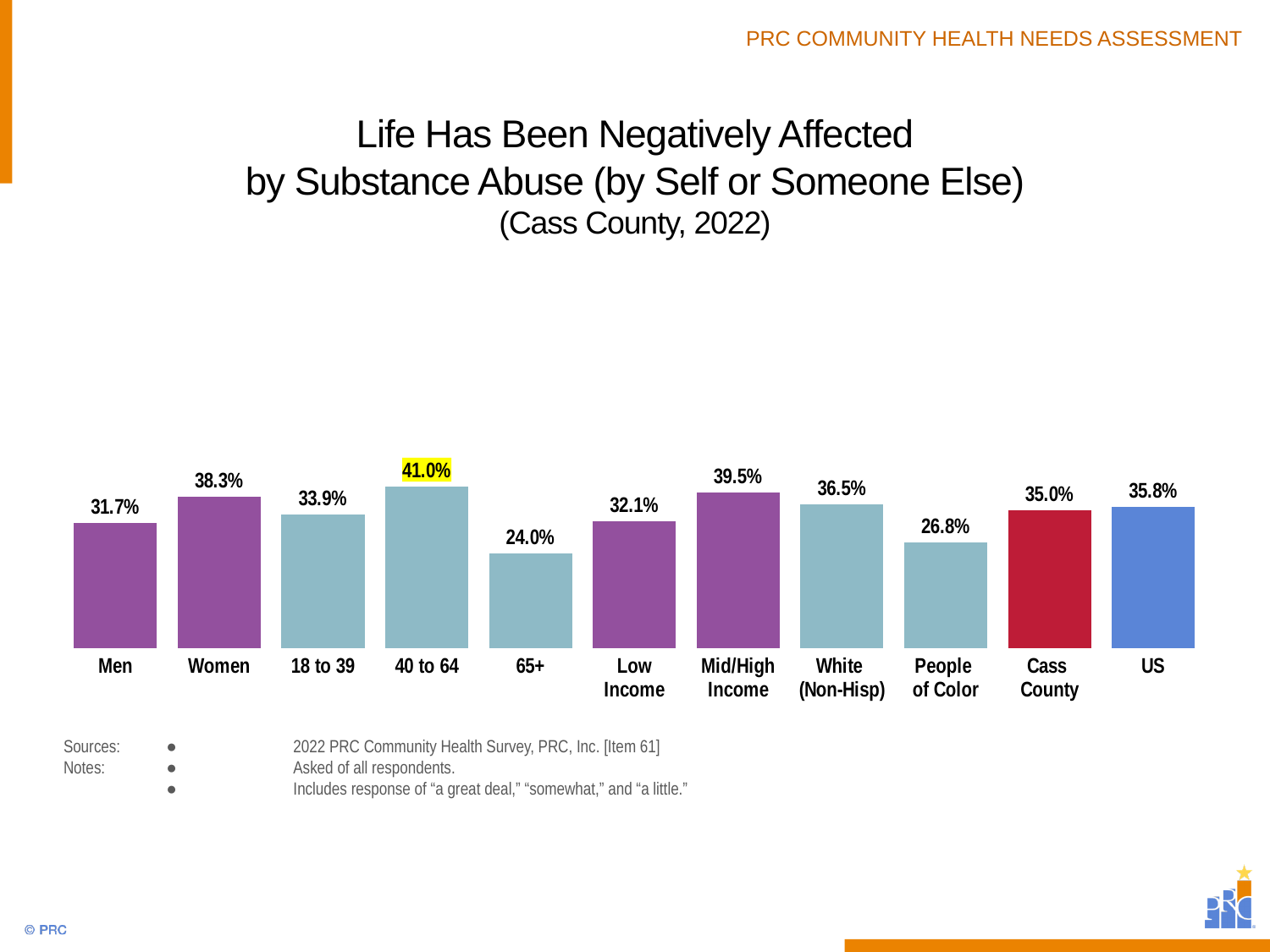
Which is larger, the value for White (Non-Hisp) or the value for People of Color? White (Non-Hisp) What is the value for Cass County? 35.0% What kind of chart is shown on the slide? Bar chart Which category has the lowest value? 65+ Which is larger, the value for Cass County or the value for US? US What is the difference between the values for Women and Men? 6.6% How many categories are shown in the chart? 11 Which category's data label is highlighted in yellow? 40 to 64 What is the value for People of Color? 26.8% What is the value for Women? 38.3% Which category has the highest value? 40 to 64 What is the difference between the values for Mid/High Income and Low Income? 7.4%